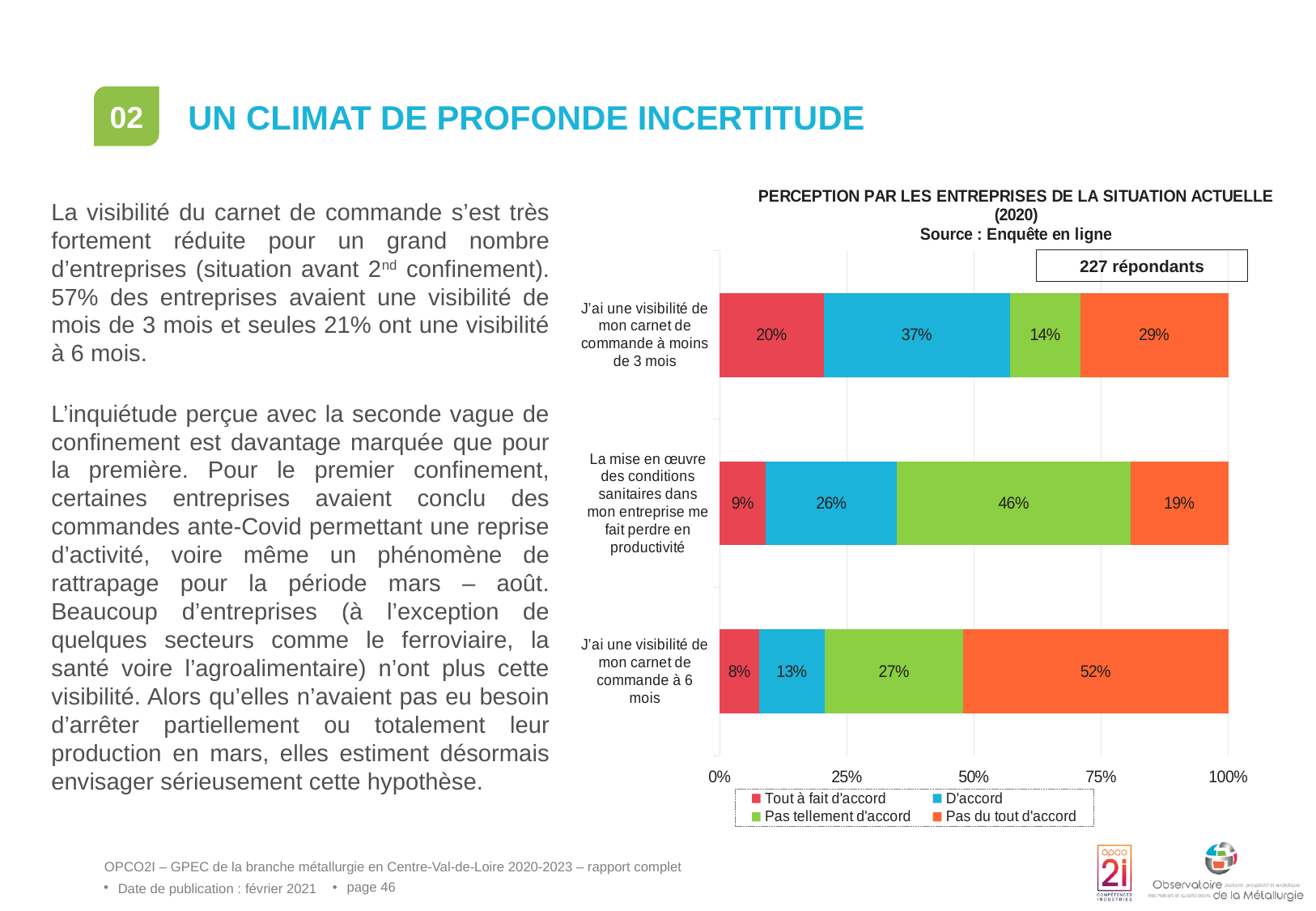
What is the value of "D'accord" for "J'ai une visibilité de mon carnet de commande à moins de 3 mois"? 37% What is the difference between the "Pas du tout d'accord" values for "J'ai une visibilité de mon carnet de commande à 6 mois" and "J'ai une visibilité de mon carnet de commande à moins de 3 mois"? 23% How many series does the legend list? 4 What is the value of "Tout à fait d'accord" for "J'ai une visibilité de mon carnet de commande à 6 mois"? 8% Which statement has the highest "Tout à fait d'accord" value? J'ai une visibilité de mon carnet de commande à moins de 3 mois What kind of chart is shown on the slide? Stacked bar chart Which statement has the lowest "D'accord" value? J'ai une visibilité de mon carnet de commande à 6 mois What is the value of "Pas tellement d'accord" for "La mise en œuvre des conditions sanitaires dans mon entreprise me fait perdre en productivité"? 46% How many respondents does the chart indicate? 227 répondants How many categories (statements) are plotted on the chart? 3 Which is larger for "La mise en œuvre des conditions sanitaires dans mon entreprise me fait perdre en productivité": "D'accord" or "Pas du tout d'accord"? D'accord What is the value of "Pas du tout d'accord" for "J'ai une visibilité de mon carnet de commande à 6 mois"? 52%